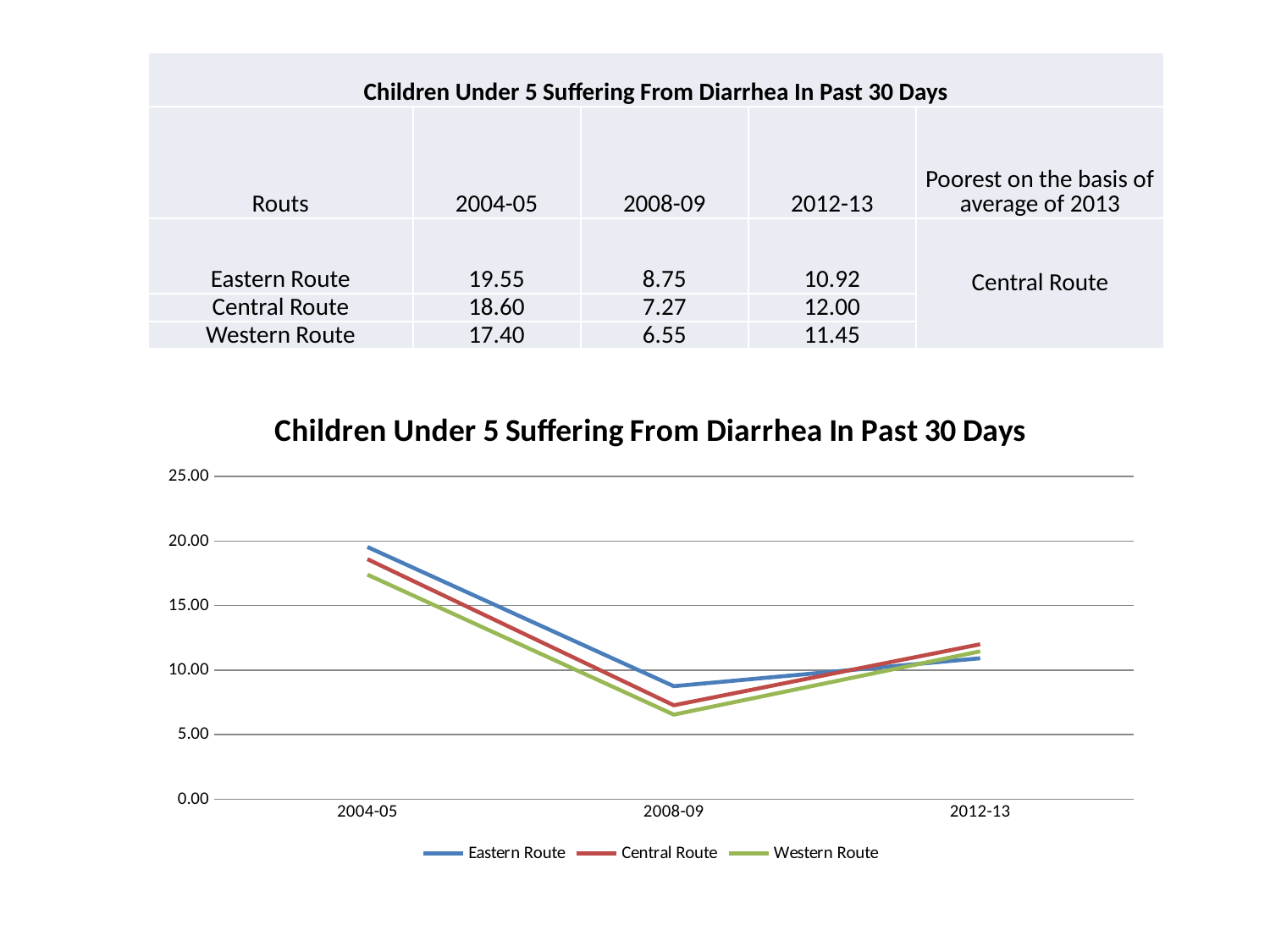
Which route has the highest value in 2004-05? Eastern Route What is the title of the chart? Children Under 5 Suffering From Diarrhea In Past 30 Days What is the value for Eastern Route in 2004-05? 19.55 How many series does the chart legend list? 3 Do the values for Eastern Route rise or fall from 2004-05 to 2008-09? fall What kind of chart is shown on the slide? line chart Which is larger in 2012-13, the Central Route value or the Eastern Route value? Central Route How many time periods are plotted along the x axis of the chart? 3 What is the value for Western Route in 2008-09? 6.55 Which route has the lowest value in 2008-09? Western Route What is the difference between the Eastern Route and Western Route values in 2004-05? 2.15 What is the value for Central Route in 2012-13? 12.00